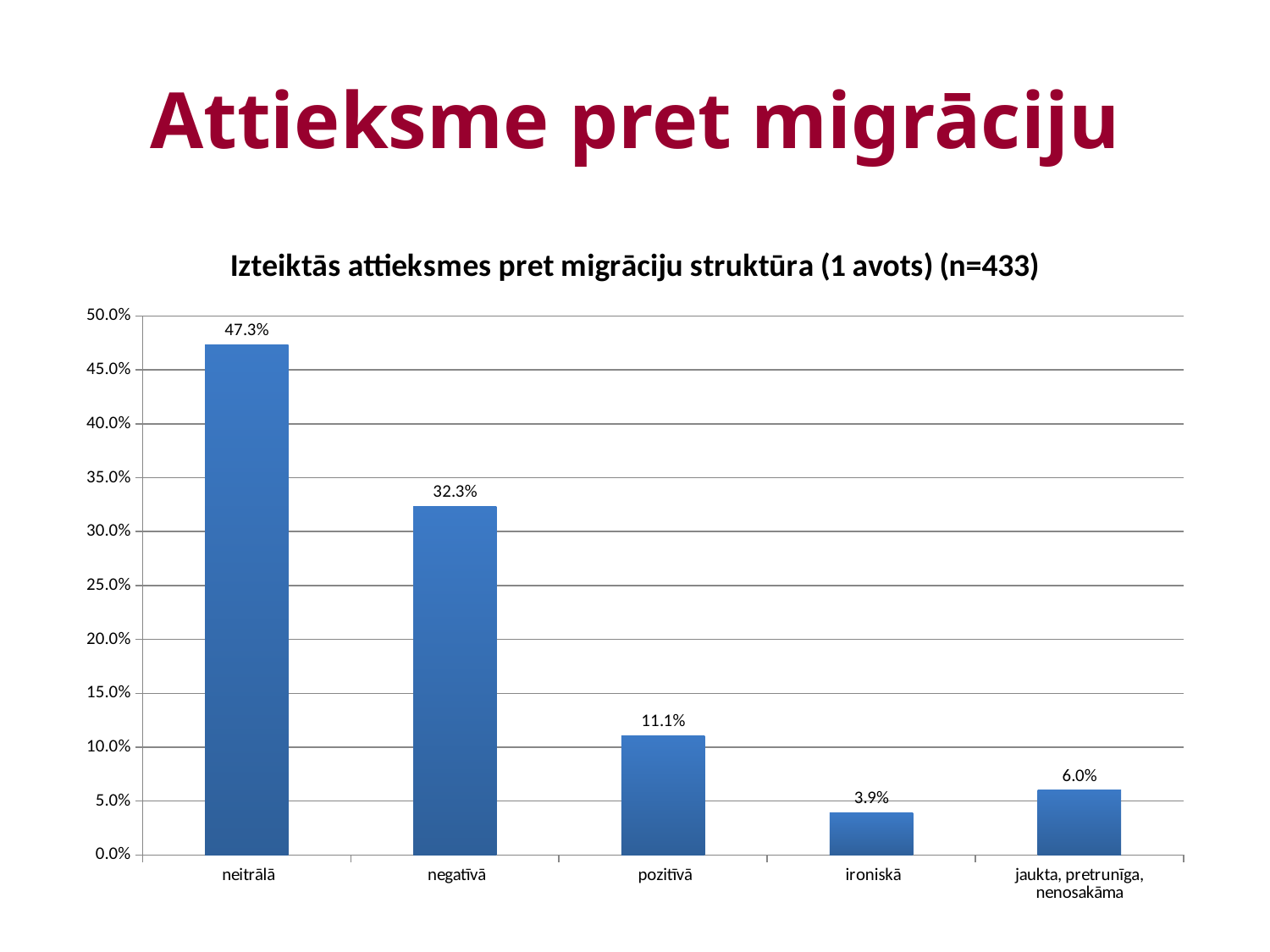
What is the value for neitrālā? 47.3% What kind of chart is shown on the slide? bar chart What is the value for jaukta, pretrunīga, nenosakāma? 6.0% What is the title of the chart? Izteiktās attieksmes pret migrāciju struktūra (1 avots) (n=433) How many categories are shown on the x axis? 5 What is the value for negatīvā? 32.3% Which is larger, the value for pozitīvā or the value for jaukta, pretrunīga, nenosakāma? pozitīvā Which category has the highest value? neitrālā What is the difference between the values for neitrālā and negatīvā? 15.0% Which category has the lowest value? ironiskā What is the value for pozitīvā? 11.1% What is the value for ironiskā? 3.9%